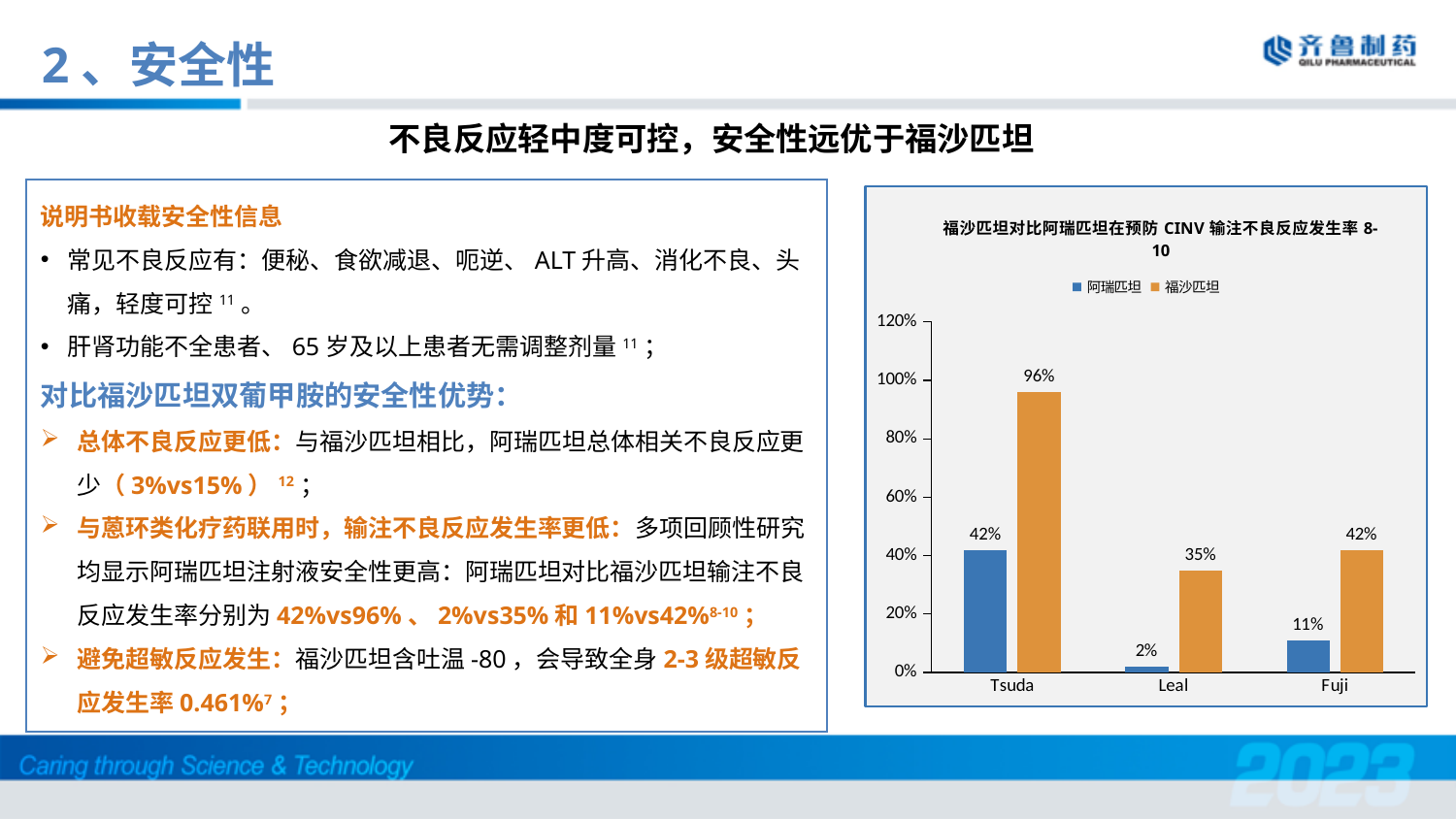
Which study has the lowest value for 阿瑞匹坦? Leal What kind of chart is shown on the slide? Bar chart What is the value for 阿瑞匹坦 in the Tsuda study? 42% What is the value for 福沙匹坦 in the Tsuda study? 96% What is the value for 阿瑞匹坦 in the Leal study? 2% What is the difference between 福沙匹坦 and 阿瑞匹坦 in the Leal study? 33% In the Fuji study, which is larger: 阿瑞匹坦 or 福沙匹坦? 福沙匹坦 How many series does the legend list? 2 What is the value for 福沙匹坦 in the Fuji study? 42% How many studies are shown on the x axis? 3 Which study has the highest value for 福沙匹坦? Tsuda Which colour represents 福沙匹坦 in the chart? Orange